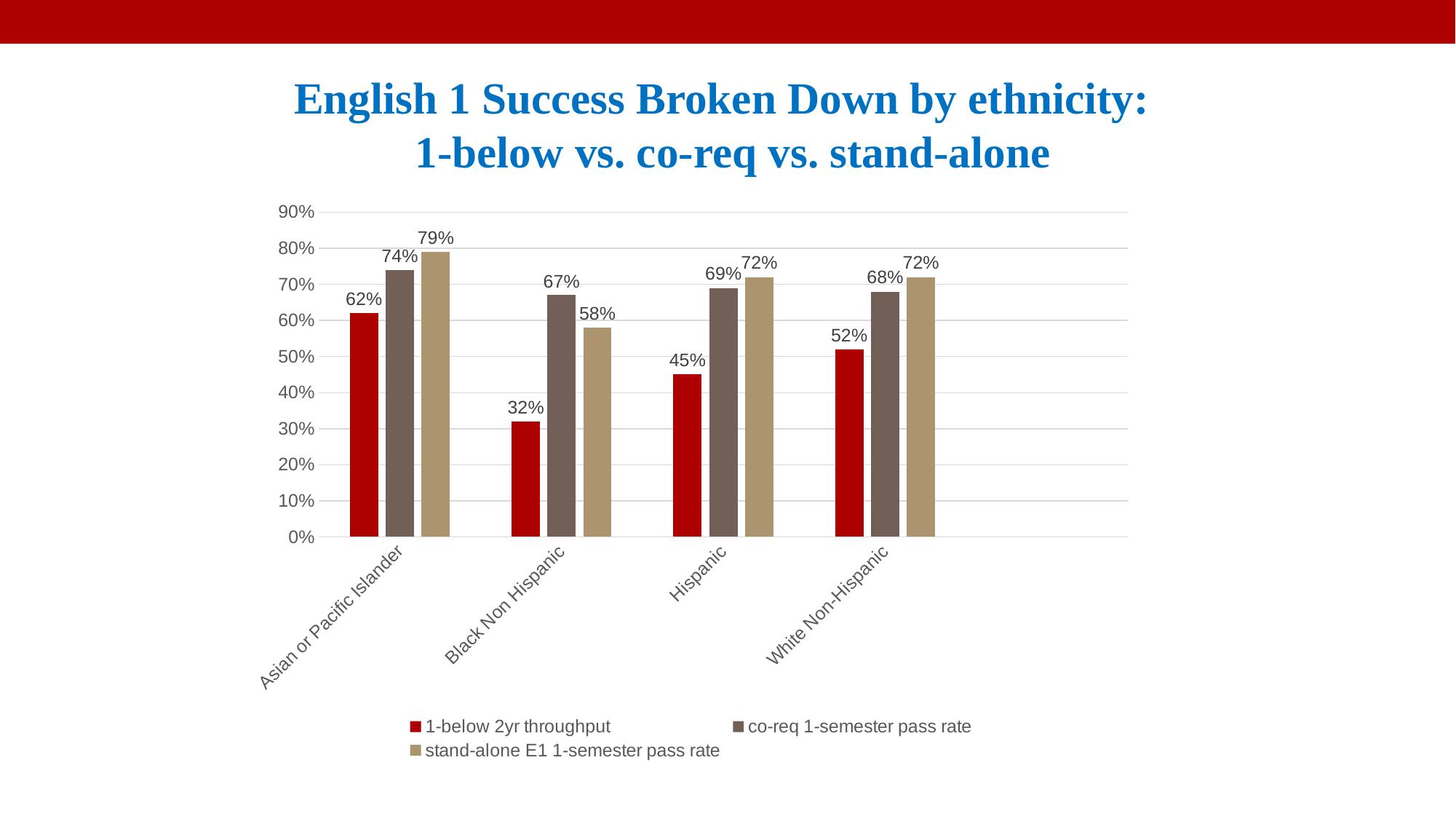
Which ethnicity has the lowest stand-alone E1 1-semester pass rate? Black Non Hispanic What kind of chart is shown on the slide? bar chart For White Non-Hispanic students, which is larger: the co-req 1-semester pass rate or the stand-alone E1 1-semester pass rate? stand-alone E1 1-semester pass rate What is the co-req 1-semester pass rate for Hispanic students? 69% Which ethnicity has the highest 1-below 2yr throughput? Asian or Pacific Islander What is the stand-alone E1 1-semester pass rate for Asian or Pacific Islander students? 79% What is the 1-below 2yr throughput for Black Non Hispanic students? 32% What is the difference between the co-req 1-semester pass rate and the 1-below 2yr throughput for Black Non Hispanic students? 35% Is the 1-below 2yr throughput for Hispanic students greater or less than 50%? less How many ethnicity categories are shown on the x axis? 4 What colour are the bars for the 1-below 2yr throughput series? red How many series does the legend list? 3